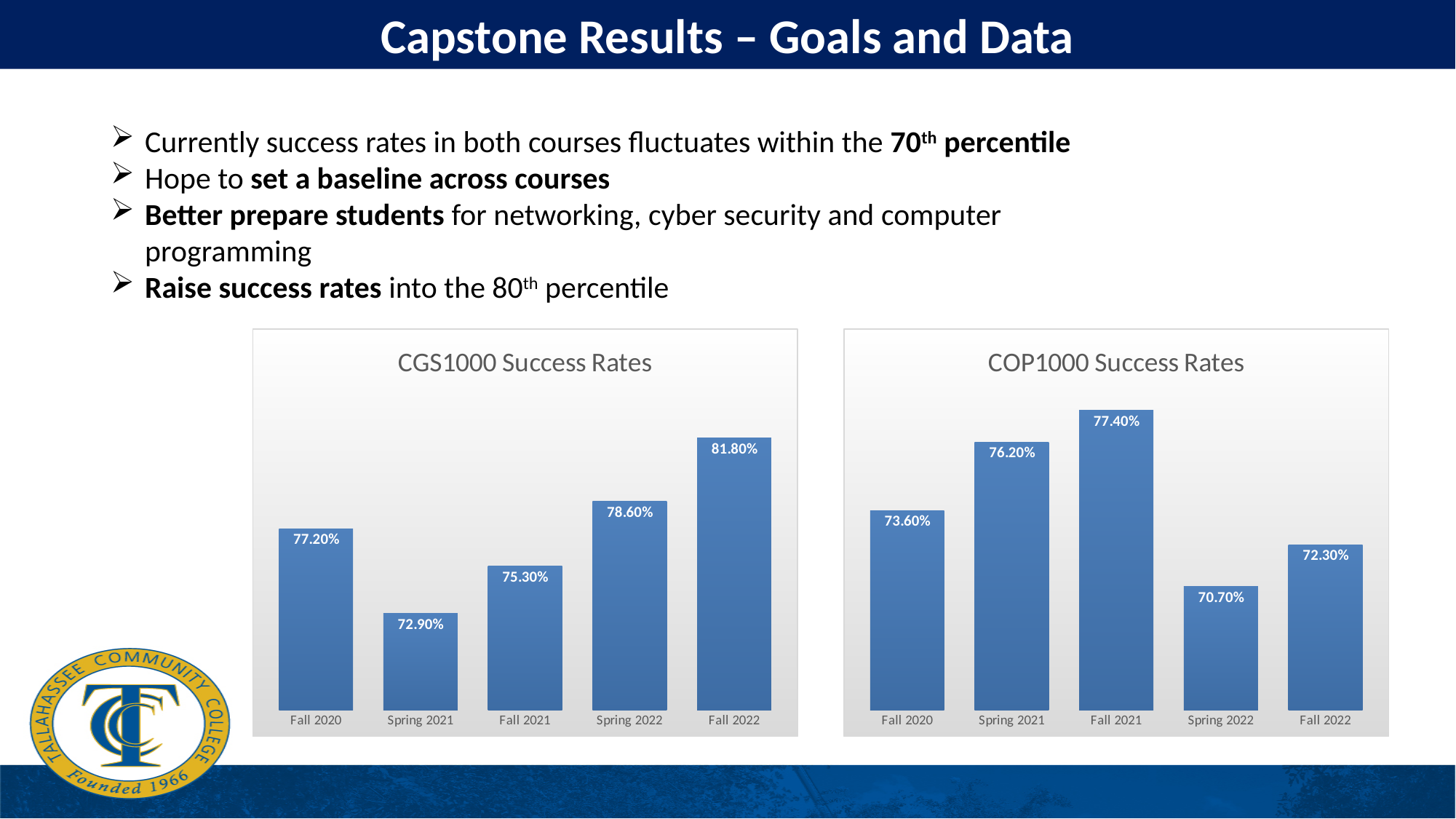
What kind of chart is the COP1000 Success Rates chart? Bar chart In the CGS1000 Success Rates chart, what is the value for Spring 2022? 78.60% In the CGS1000 Success Rates chart, what is the difference between the Fall 2022 and Fall 2020 values? 4.60% In the CGS1000 Success Rates chart, do the values rise or fall from Spring 2021 to Fall 2022? Rise In the COP1000 Success Rates chart, what is the difference between the Fall 2021 and Spring 2022 values? 6.70% In the CGS1000 Success Rates chart, which term has the lowest success rate? Spring 2021 In the COP1000 Success Rates chart, what is the value for Spring 2022? 70.70% What is the title of the chart on the right side of the slide? COP1000 Success Rates How many terms are shown in the CGS1000 Success Rates chart? 5 In the CGS1000 Success Rates chart, what is the value for Fall 2022? 81.80% In the COP1000 Success Rates chart, which term has the highest success rate? Fall 2021 In the COP1000 Success Rates chart, which is larger, the value for Fall 2020 or the value for Fall 2022? Fall 2020